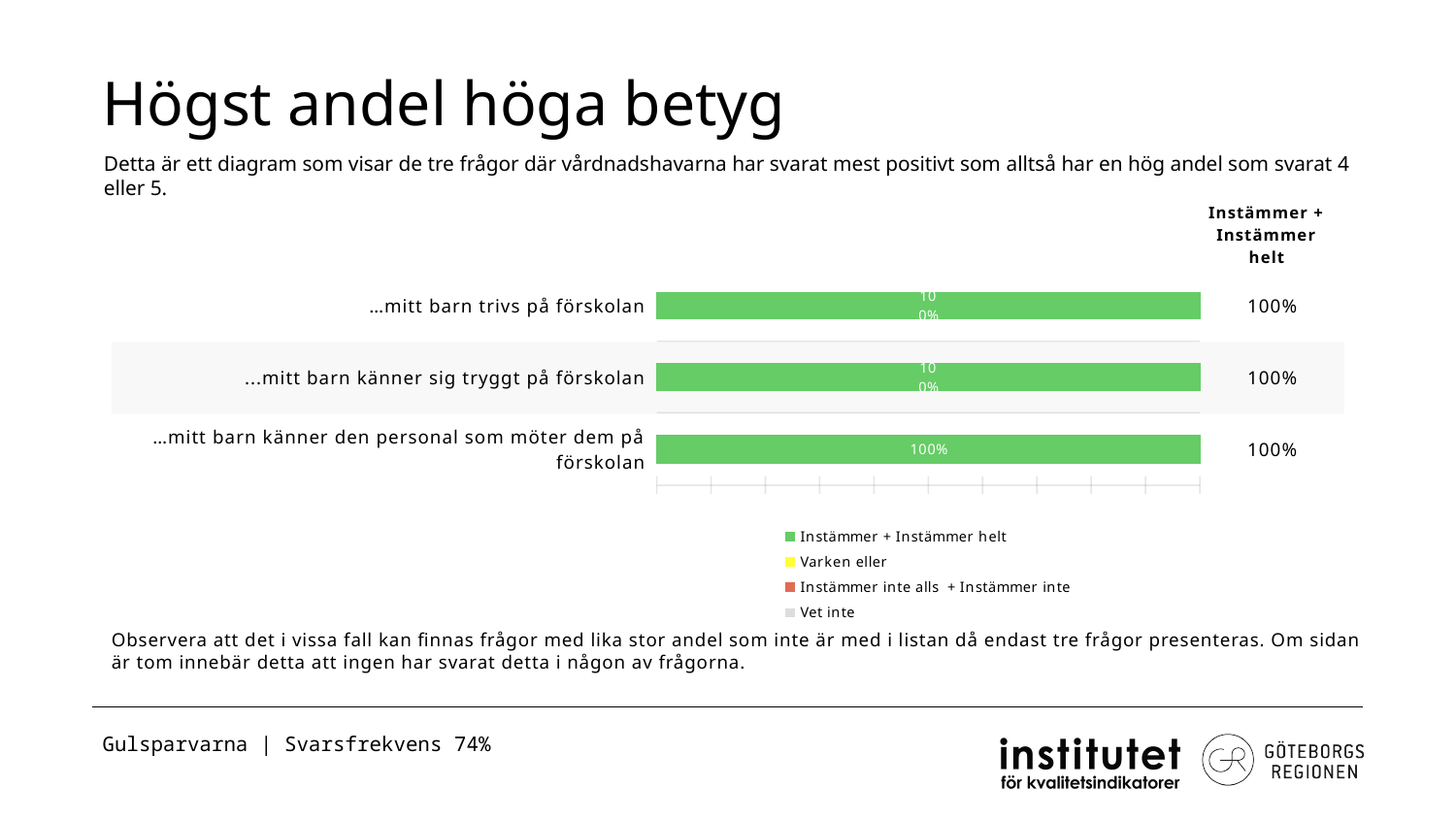
Which legend entry is shown in yellow? Varken eller What is the 'Instämmer + Instämmer helt' value for '…mitt barn trivs på förskolan'? 100% What is the title of the slide containing the chart? Högst andel höga betyg What is the difference between the 'Instämmer + Instämmer helt' values for '…mitt barn trivs på förskolan' and '…mitt barn känner den personal som möter dem på förskolan'? 0% What is the 'Instämmer + Instämmer helt' value for '…mitt barn känner den personal som möter dem på förskolan'? 100% How many categories (questions) are plotted in the chart? 3 Which legend entry is shown in green? Instämmer + Instämmer helt What kind of chart is shown on the slide? bar chart What is the 'Instämmer + Instämmer helt' value for '...mitt barn känner sig tryggt på förskolan'? 100% How many series does the legend list? 4